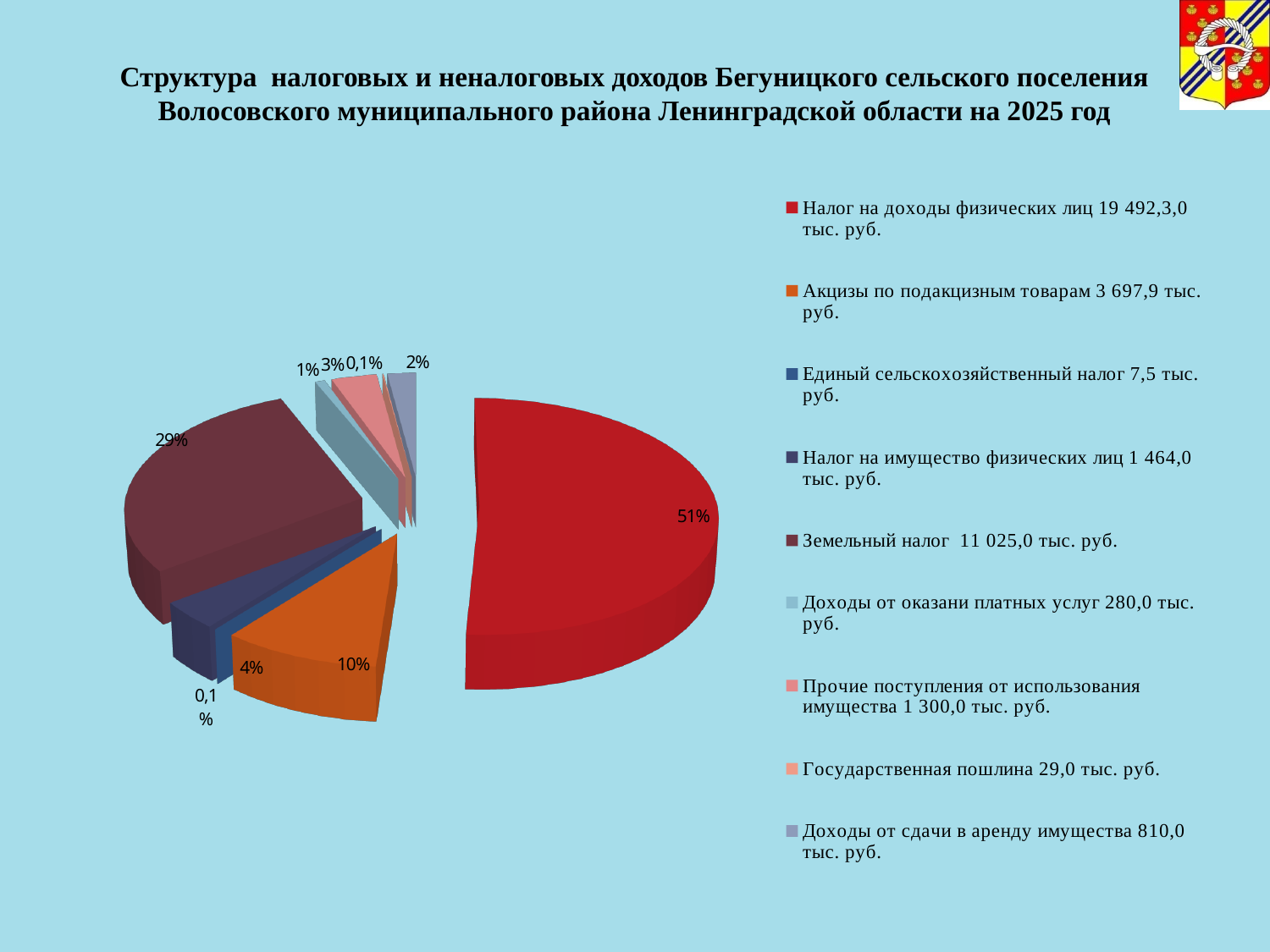
What is the difference in percentage points between the share for "Налог на доходы физических лиц" and the share for "Земельный налог"? 22 How many entries does the legend list? 9 What share of the pie does "Акцизы по подакцизным товарам" take? 10% What share of the pie does "Налог на имущество физических лиц" take? 4% How many slices does the pie chart have? 9 Which is larger: the share for "Земельный налог" or the share for "Акцизы по подакцизным товарам"? Земельный налог What share of the pie does "Земельный налог" take? 29% What amount does the legend give for "Государственная пошлина"? 29,0 тыс. руб. Which category has the largest slice of the pie? Налог на доходы физических лиц What amount does the legend give for "Земельный налог"? 11 025,0 тыс. руб. What kind of chart is shown on the slide? pie chart